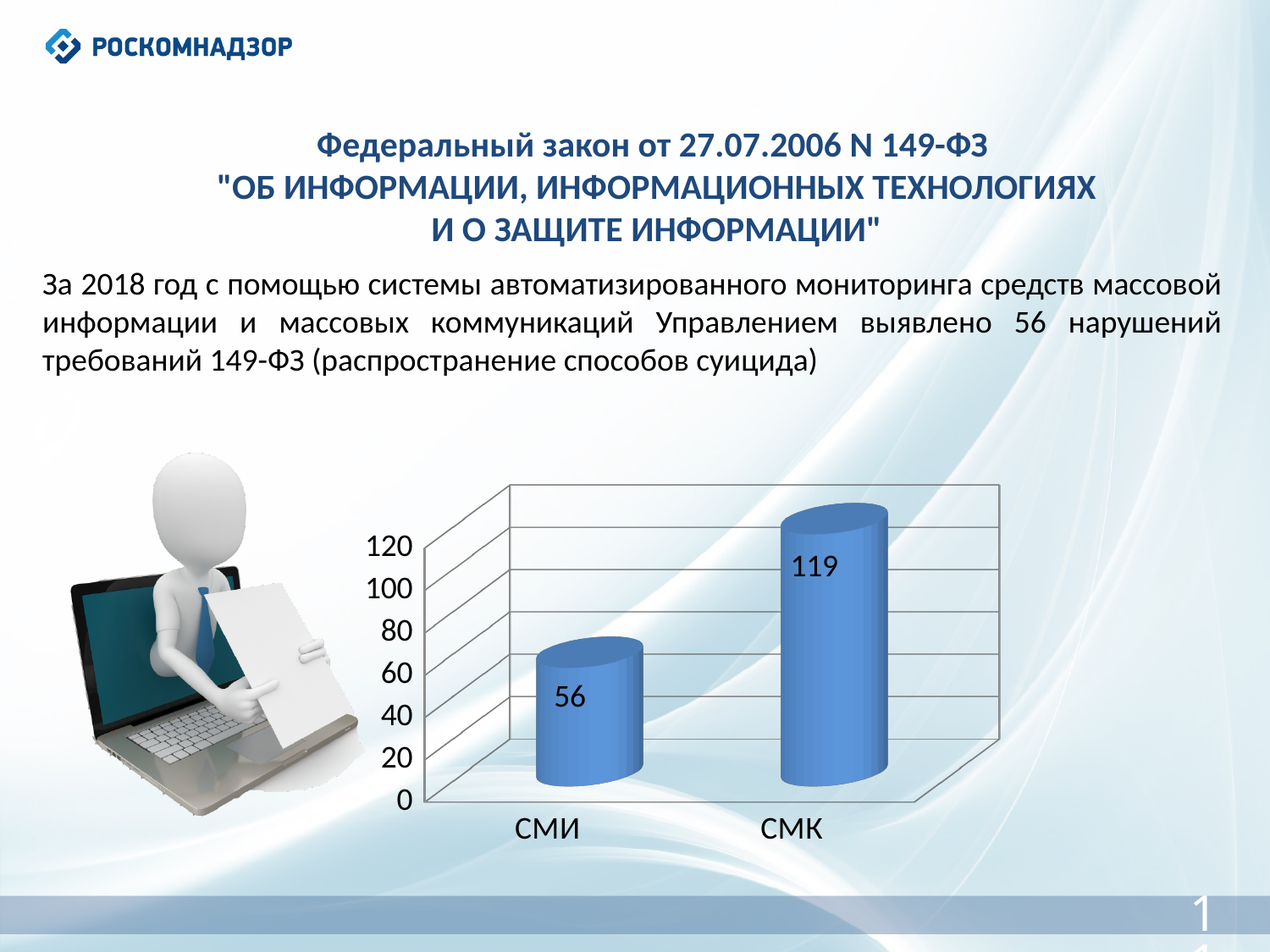
What is the maximum value shown on the vertical axis? 120 What is the difference between the values for СМК and СМИ? 63 How many categories are shown in the chart? 2 What kind of chart is shown on the slide? bar chart Which category has the highest value? СМК Is the value for СМК greater or less than 100? greater Which category has the lowest value? СМИ What colour are the bars in the chart? blue What is the value for СМК? 119 What is the value for СМИ? 56 Which is larger, the value for СМИ or the value for СМК? СМК Is the value for СМИ greater or less than 80? less